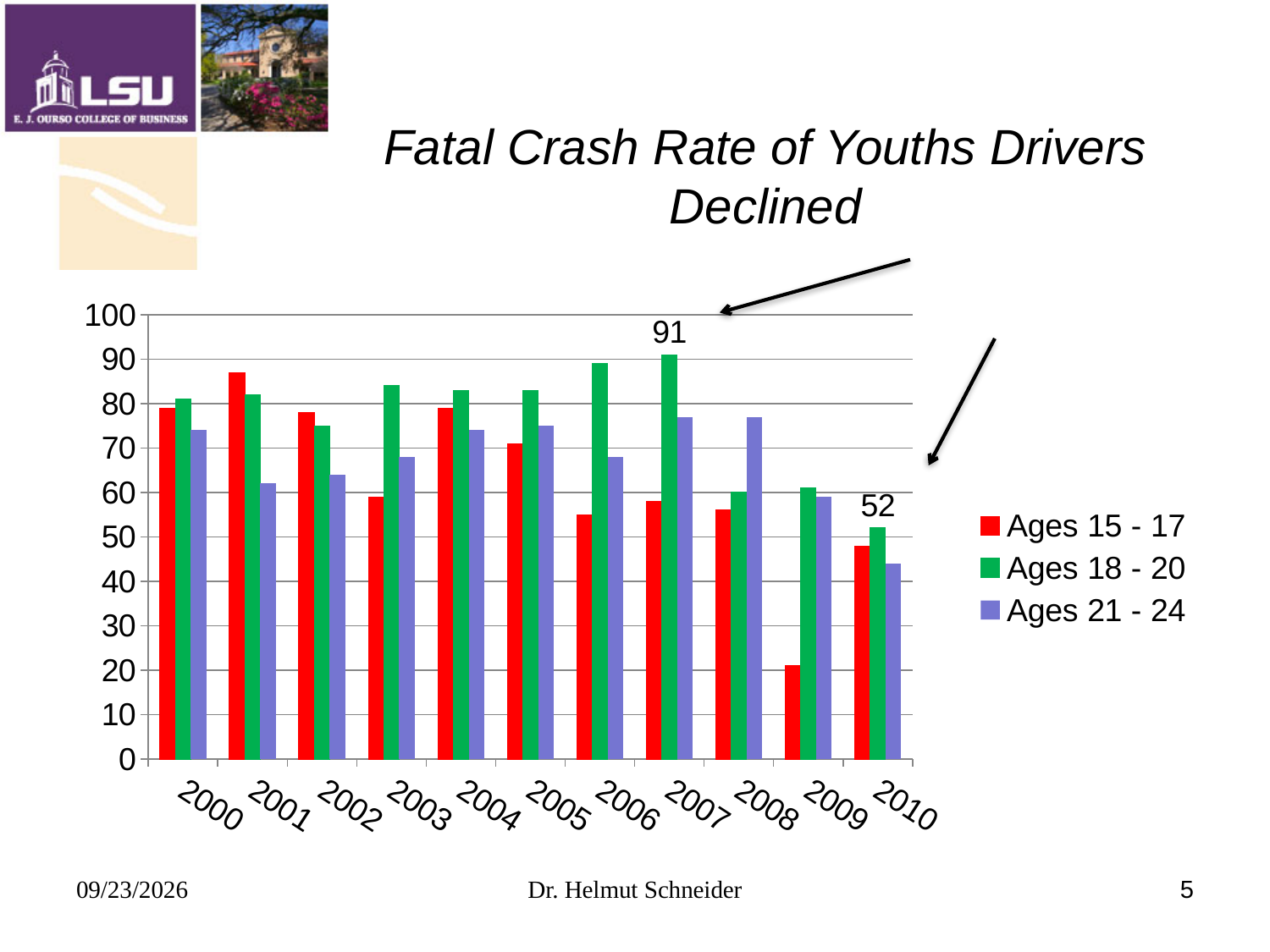
Is the value for Ages 15 - 17 in 2009 greater or less than 30? less What kind of chart is shown on the slide? Bar chart What is the difference between the Ages 18 - 20 values in 2007 and 2010? 39 What is the title of the chart? Fatal Crash Rate of Youths Drivers Declined How many years are shown on the x axis? 11 What is the value for Ages 18 - 20 in 2007? 91 Is the value for Ages 15 - 17 in 2001 greater or less than 80? greater What is the value for Ages 18 - 20 in 2010? 52 How many series does the legend list? 3 In 2008, which is larger: Ages 18 - 20 or Ages 21 - 24? Ages 21 - 24 In which year is the Ages 15 - 17 bar lowest? 2009 In which year is the Ages 18 - 20 bar highest? 2007